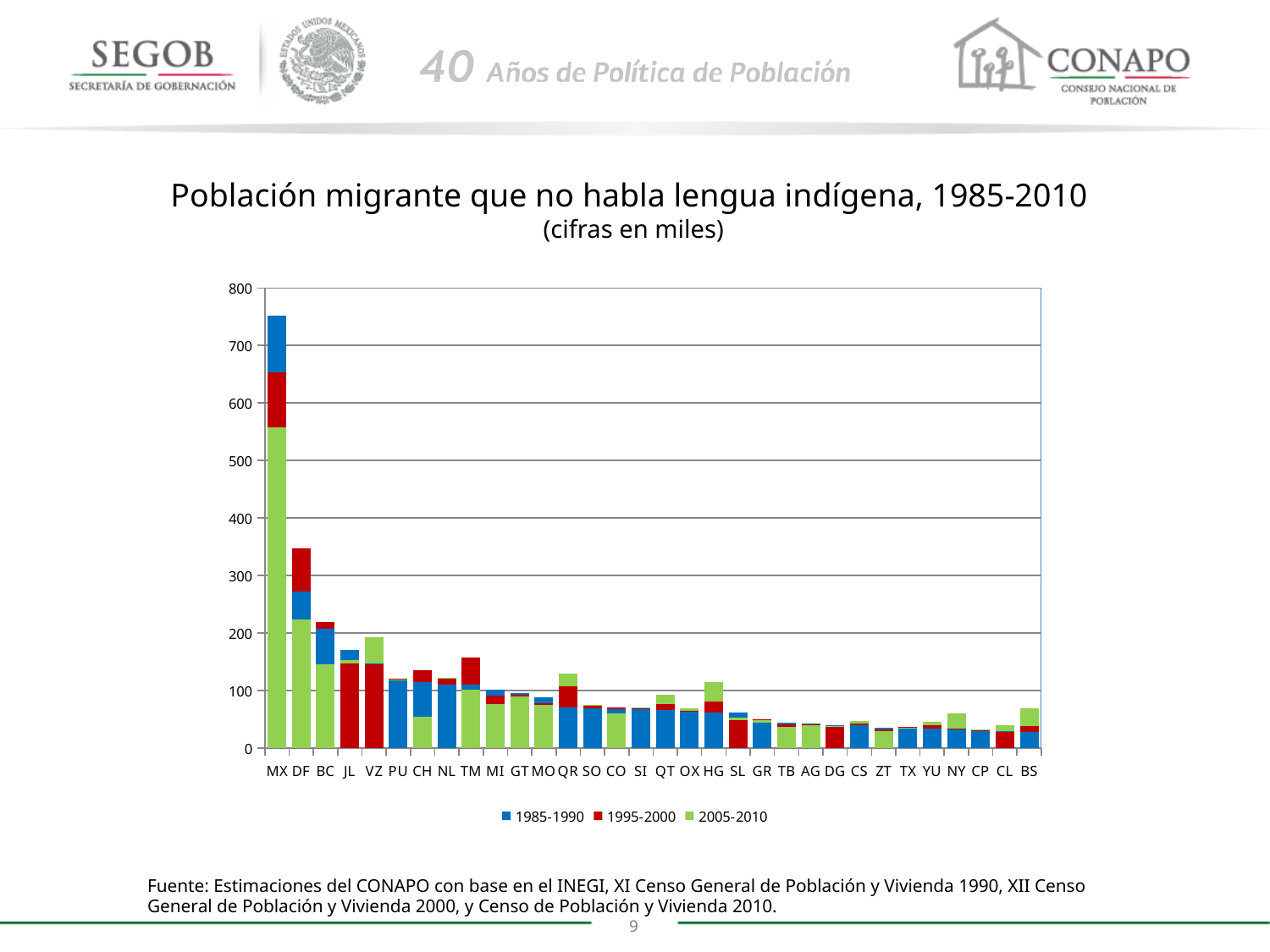
Is the total value for JL greater or less than 200? less Is the total value for PU greater or less than 100? greater Do the total bar heights generally rise or fall from left to right along the x axis? Fall How many series does the legend list? 3 Is the total value for MX greater or less than 700? greater How many categories (states) are shown on the x axis? 32 Which category has the highest total stacked bar? MX What is the title of the chart? Población migrante que no habla lengua indígena, 1985-2010 (cifras en miles) What are the three periods listed in the legend? 1985-1990, 1995-2000, 2005-2010 Which has the larger total, DF or BC? DF What kind of chart is shown on the slide? Stacked bar chart